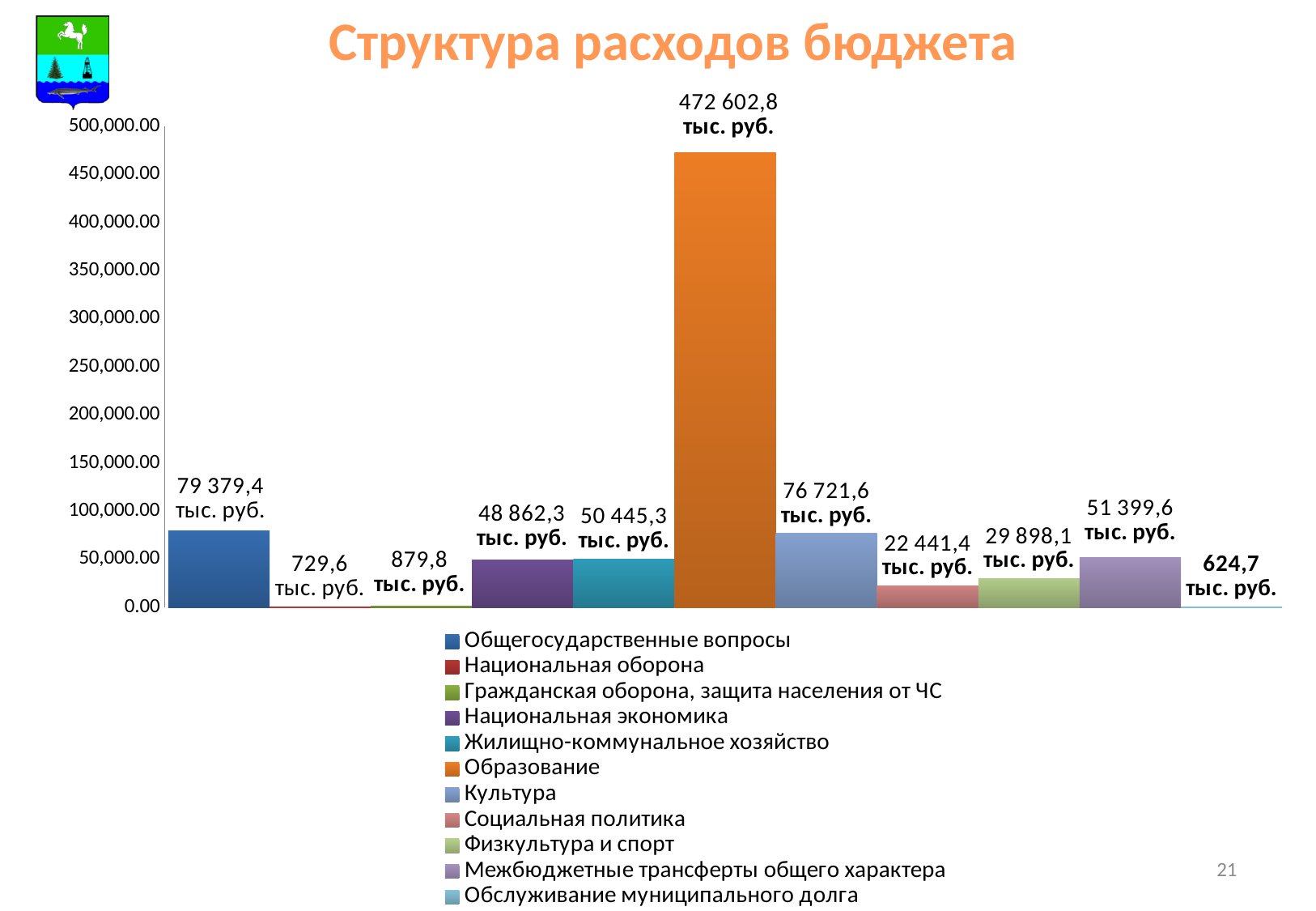
What is the difference between Физкультура и спорт and Социальная политика? 7 456,7 тыс. руб. What is the value for Обслуживание муниципального долга? 624,7 тыс. руб. What is the value for Культура? 76 721,6 тыс. руб. Which category has the lowest value? Обслуживание муниципального долга How many series does the legend list? 11 What kind of chart is shown on the slide? bar chart What is the value for Социальная политика? 22 441,4 тыс. руб. What is the difference between Образование and Культура? 395 881,2 тыс. руб. Is the value for Национальная экономика greater or less than 100,000.00? less Which category has the highest value? Образование What is the value for Образование? 472 602,8 тыс. руб. Which is larger, Общегосударственные вопросы or Культура? Общегосударственные вопросы